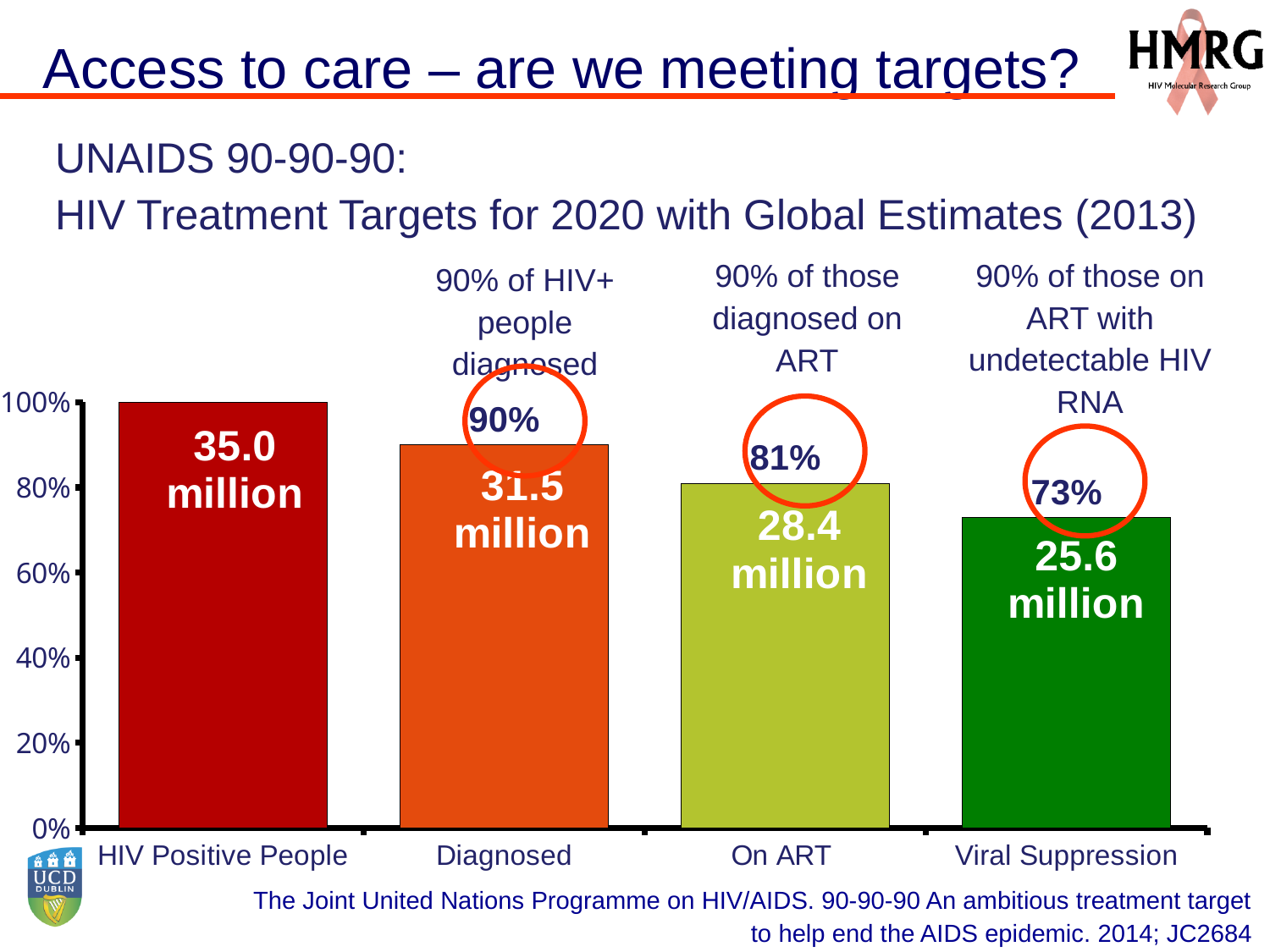
What percentage is circled above the Viral Suppression bar? 73% What value is labelled on the bar for HIV Positive People? 35.0 million What value is labelled on the bar for Diagnosed? 31.5 million Do the bar values rise or fall from left to right across the x axis? fall What percentage is circled above the On ART bar? 81% What value is labelled on the bar for On ART? 28.4 million Which category has the highest bar? HIV Positive People What kind of chart is shown on the slide? bar chart Is the value for Diagnosed greater or less than 80%? greater How many categories are plotted on the x axis of the chart? 4 What value is labelled on the bar for Viral Suppression? 25.6 million Which category has the lowest bar? Viral Suppression